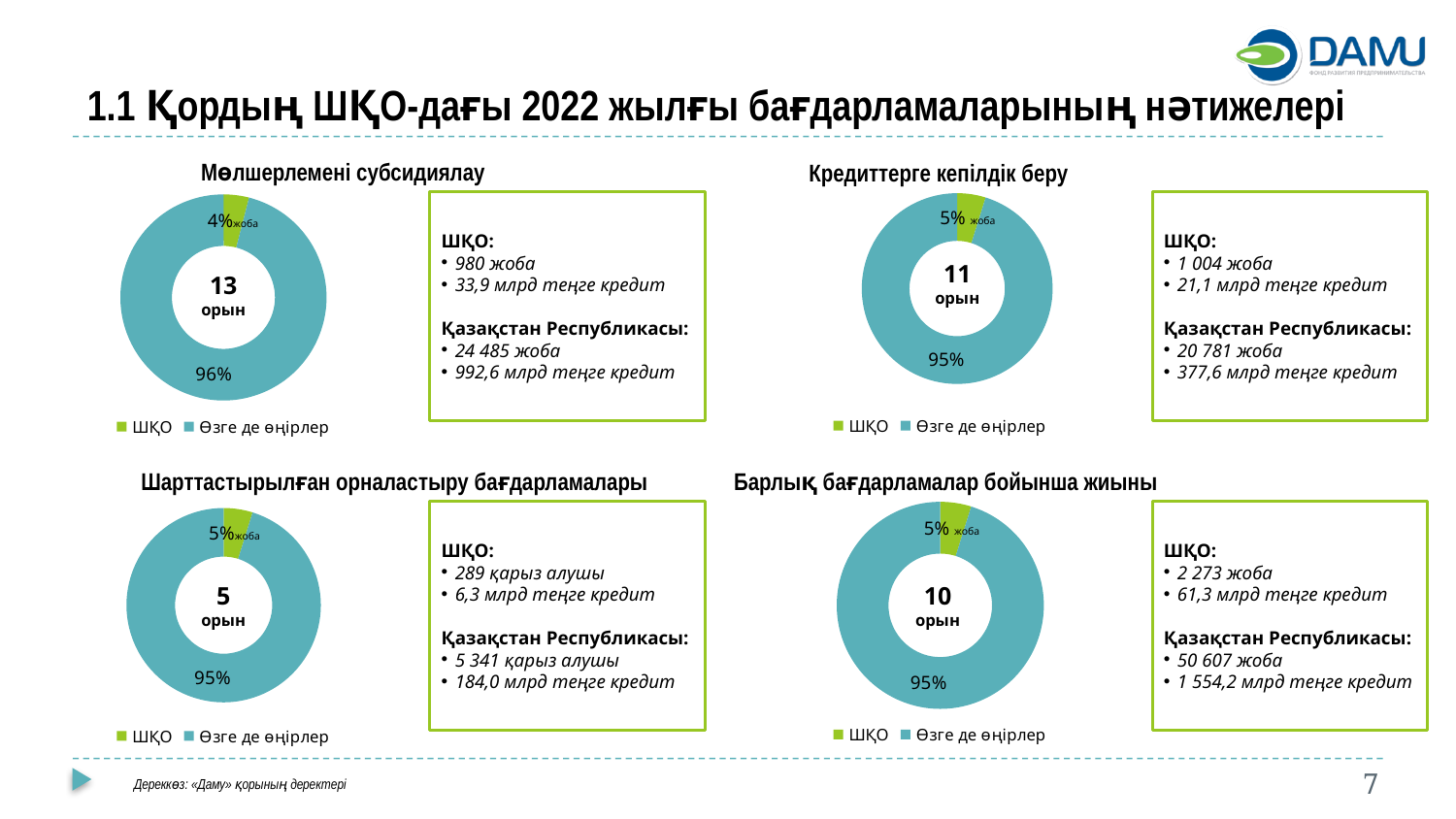
In the "Мөлшерлемені субсидиялау" chart, what is the difference between the values for Өзге де өңірлер and ШҚО? 92% In the "Барлық бағдарламалар бойынша жиыны" chart, what is the value for Өзге де өңірлер? 95% In the "Шарттастырылған орналастыру бағдарламалары" chart, what is the value for ШҚО? 5% In the "Мөлшерлемені субсидиялау" chart, which category is the largest? Өзге де өңірлер What number is shown in the centre of the "Кредиттерге кепілдік беру" chart? 11 орын What kind of chart is used for "Кредиттерге кепілдік беру"? Pie (donut) chart In the "Мөлшерлемені субсидиялау" chart, what share of the pie does ШҚО hold? 4% In the "Кредиттерге кепілдік беру" chart, what share of the pie does ШҚО hold? 5% In the "Кредиттерге кепілдік беру" chart, what is the value for Өзге де өңірлер? 95% In the "Мөлшерлемені субсидиялау" chart, what is the value for Өзге де өңірлер? 96% In the "Барлық бағдарламалар бойынша жиыны" chart, which category is the smallest? ШҚО How many categories does the legend of the "Шарттастырылған орналастыру бағдарламалары" chart list? 2